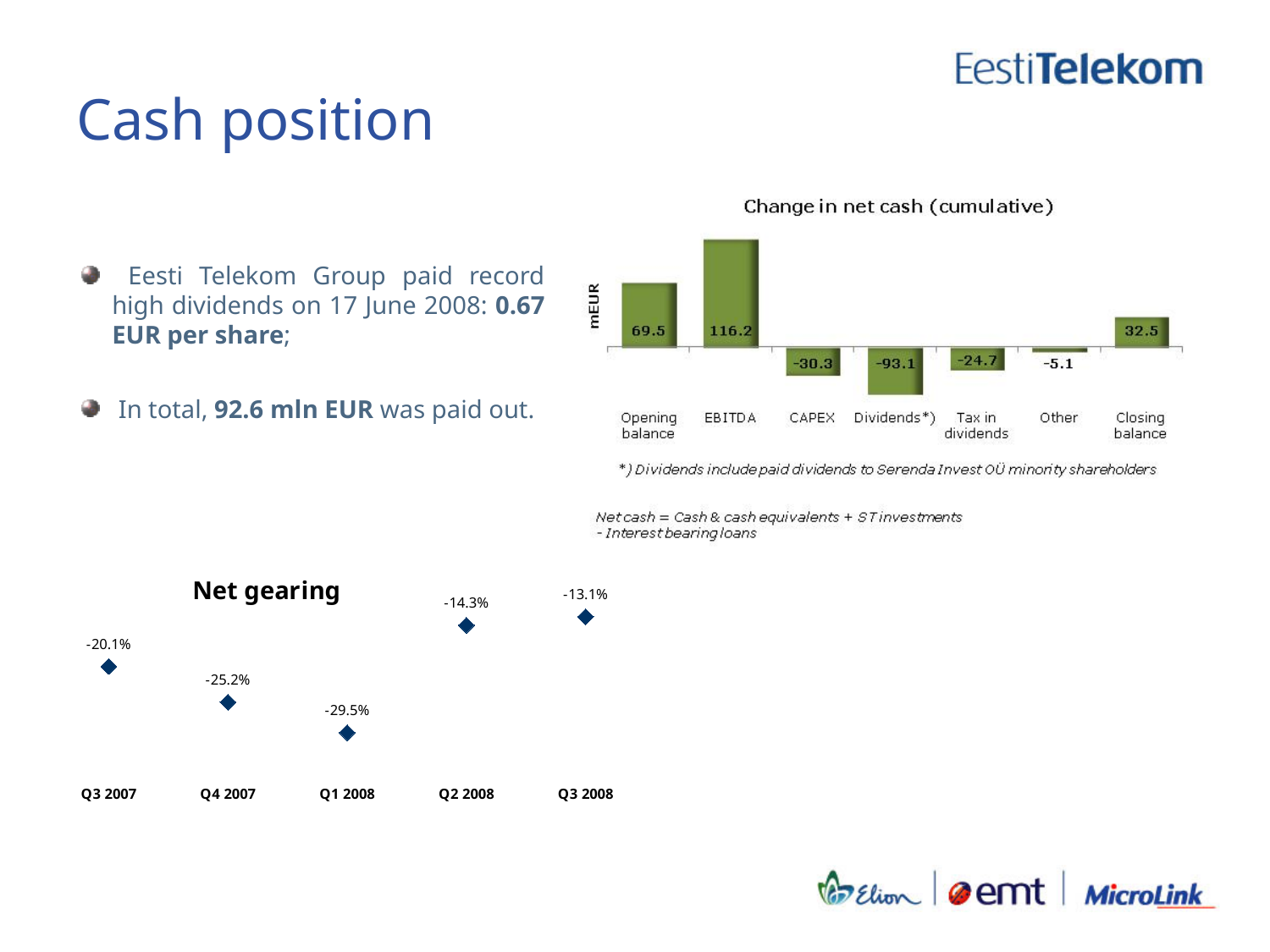
In the 'Net gearing' chart, is the value for Q3 2008 larger or smaller than the value for Q3 2007? Larger In the 'Change in net cash (cumulative)' chart, what is the closing balance? 32.5 In the 'Change in net cash (cumulative)' chart, how many categories are shown on the x axis? 7 In the 'Change in net cash (cumulative)' chart, what is the value for EBITDA? 116.2 What type of chart is 'Change in net cash (cumulative)'? Bar chart In the 'Net gearing' chart, which quarter has the lowest value? Q1 2008 In the 'Change in net cash (cumulative)' chart, which category has the lowest value? Dividends*) In the 'Change in net cash (cumulative)' chart, what is the value for Dividends*)? -93.1 In the 'Change in net cash (cumulative)' chart, which category has the highest value? EBITDA In the 'Net gearing' chart, what is the value for Q1 2008? -29.5% In the 'Change in net cash (cumulative)' chart, what unit is shown on the y axis? mEUR In the 'Change in net cash (cumulative)' chart, what is the difference between the opening balance and the closing balance? 37.0